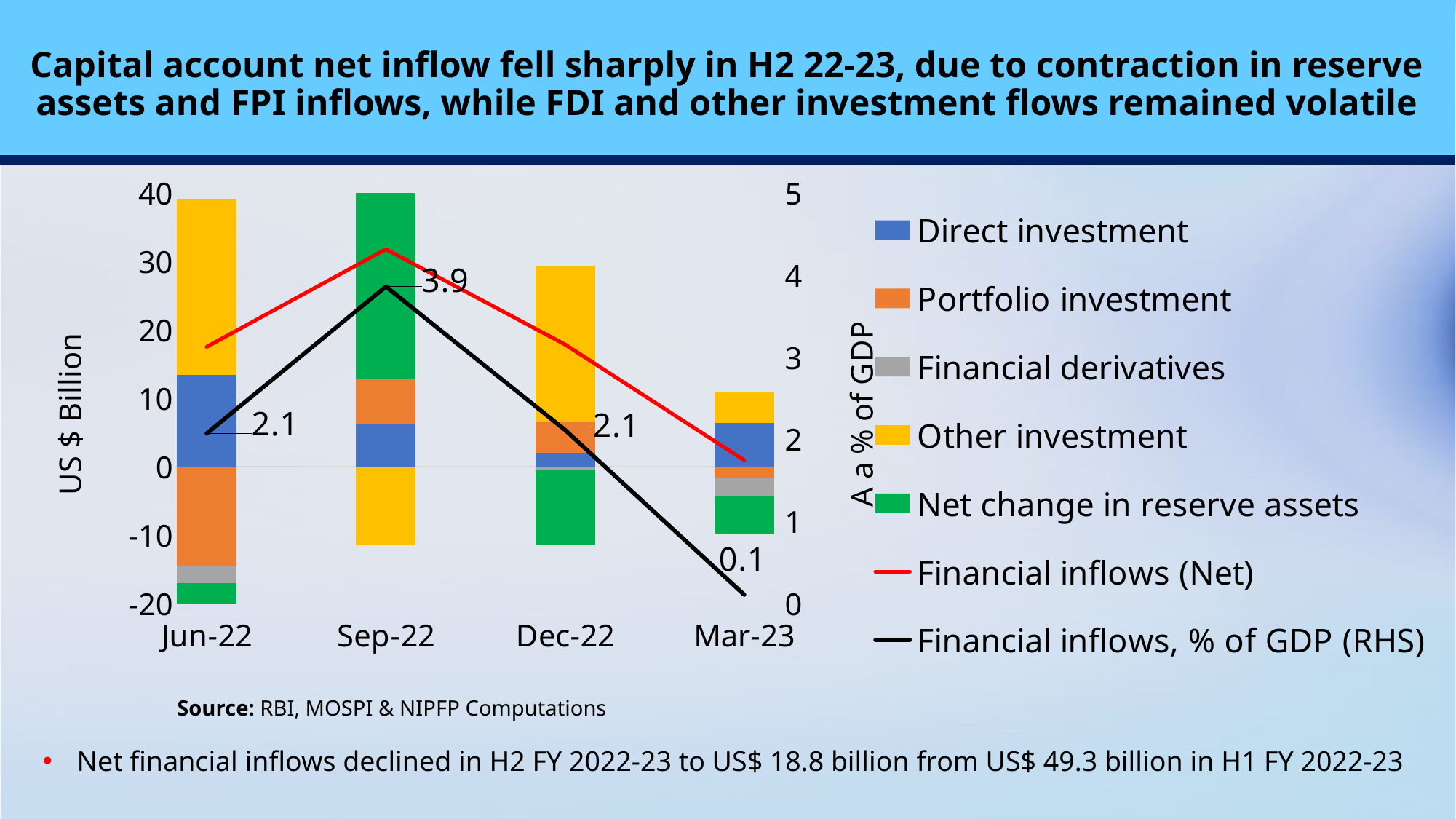
In which quarter is Financial inflows, % of GDP (RHS) highest? Sep-22 What is the difference between Financial inflows, % of GDP (RHS) in Sep-22 and Mar-23? 3.8 What is the value of Financial inflows, % of GDP (RHS) for Sep-22? 3.9 Is the value for Portfolio investment in Jun-22 greater or less than -10? less In which quarter is Financial inflows, % of GDP (RHS) lowest? Mar-23 How many quarters are shown on the x axis? 4 What is the value of Financial inflows, % of GDP (RHS) for Mar-23? 0.1 What is the value of Financial inflows, % of GDP (RHS) for Jun-22? 2.1 How many series does the legend list? 7 Which quarter has the larger Financial inflows, % of GDP (RHS): Sep-22 or Dec-22? Sep-22 Does Financial inflows, % of GDP (RHS) rise or fall from Sep-22 to Mar-23? Fall What kind of chart is shown on the slide? Stacked bar chart with line series